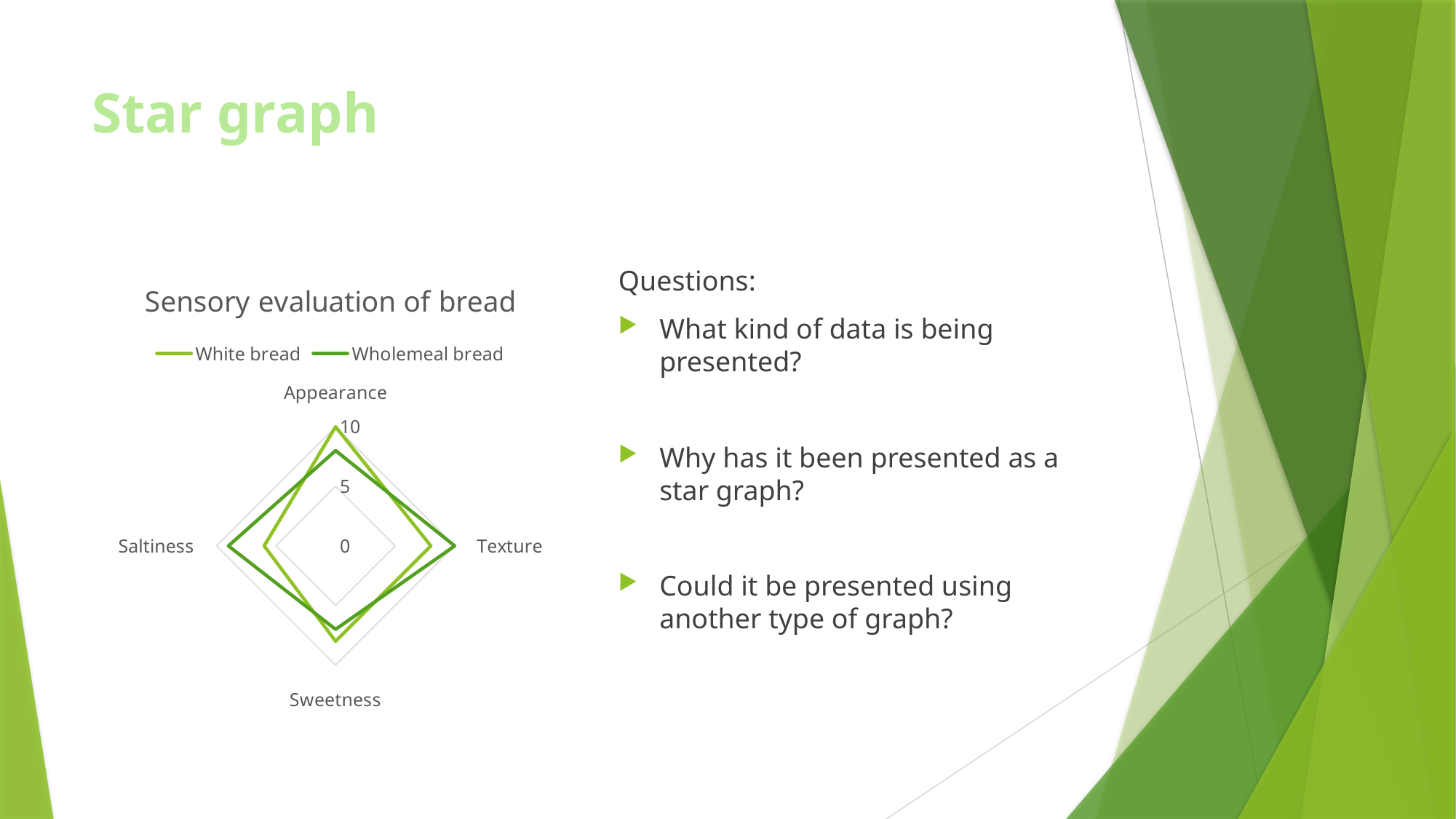
How many sensory attributes (axes) are plotted on the chart? 4 Which two series are listed in the legend? White bread and Wholemeal bread For Texture, which series has the higher value, White bread or Wholemeal bread? Wholemeal bread Is the Wholemeal bread value for Saltiness greater or less than 5? greater Is the White bread value for Appearance greater or less than 5? greater How many series does the legend list? 2 Is the Wholemeal bread value for Texture greater or less than 5? greater On which attribute does White bread score highest? Appearance What kind of chart is shown on the slide? Radar chart For Appearance, which series has the higher value, White bread or Wholemeal bread? White bread What is the title of the chart? Sensory evaluation of bread For Saltiness, which series has the higher value, White bread or Wholemeal bread? Wholemeal bread